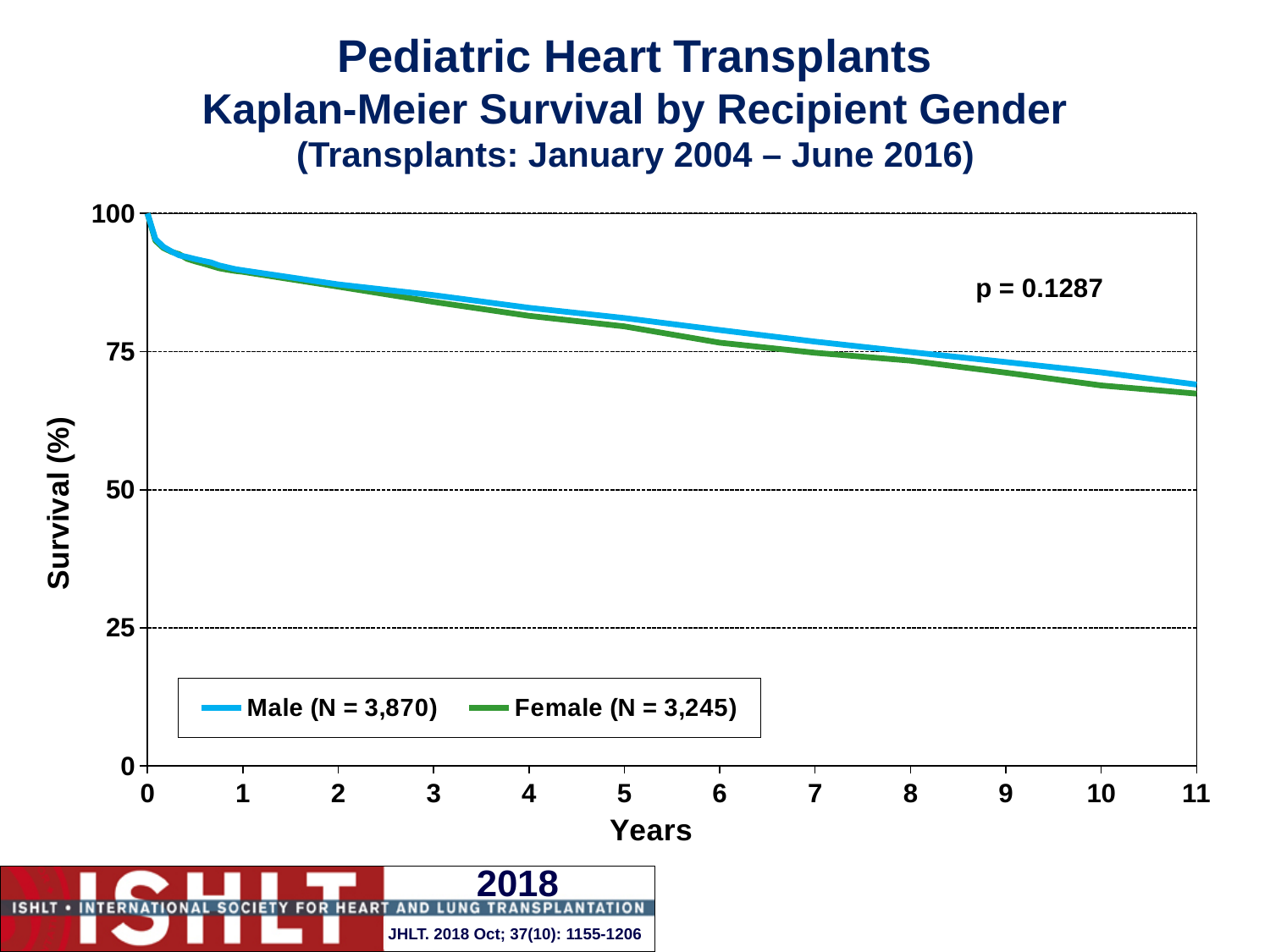
Is the survival value for Male at 1 year greater or less than 75? greater What kind of chart is shown on the slide? Line chart What is the p-value shown on the chart? p = 0.1287 What is the N for the Male group in the legend? 3,870 Is the survival value for Male at 11 years greater or less than 75? less What is the N for the Female group in the legend? 3,245 Do the survival curves rise or fall as the years increase? Fall Is the survival value for Female at 5 years greater or less than 75? greater How many series does the legend list? 2 At 10 years, which group has the higher survival, Male or Female? Male